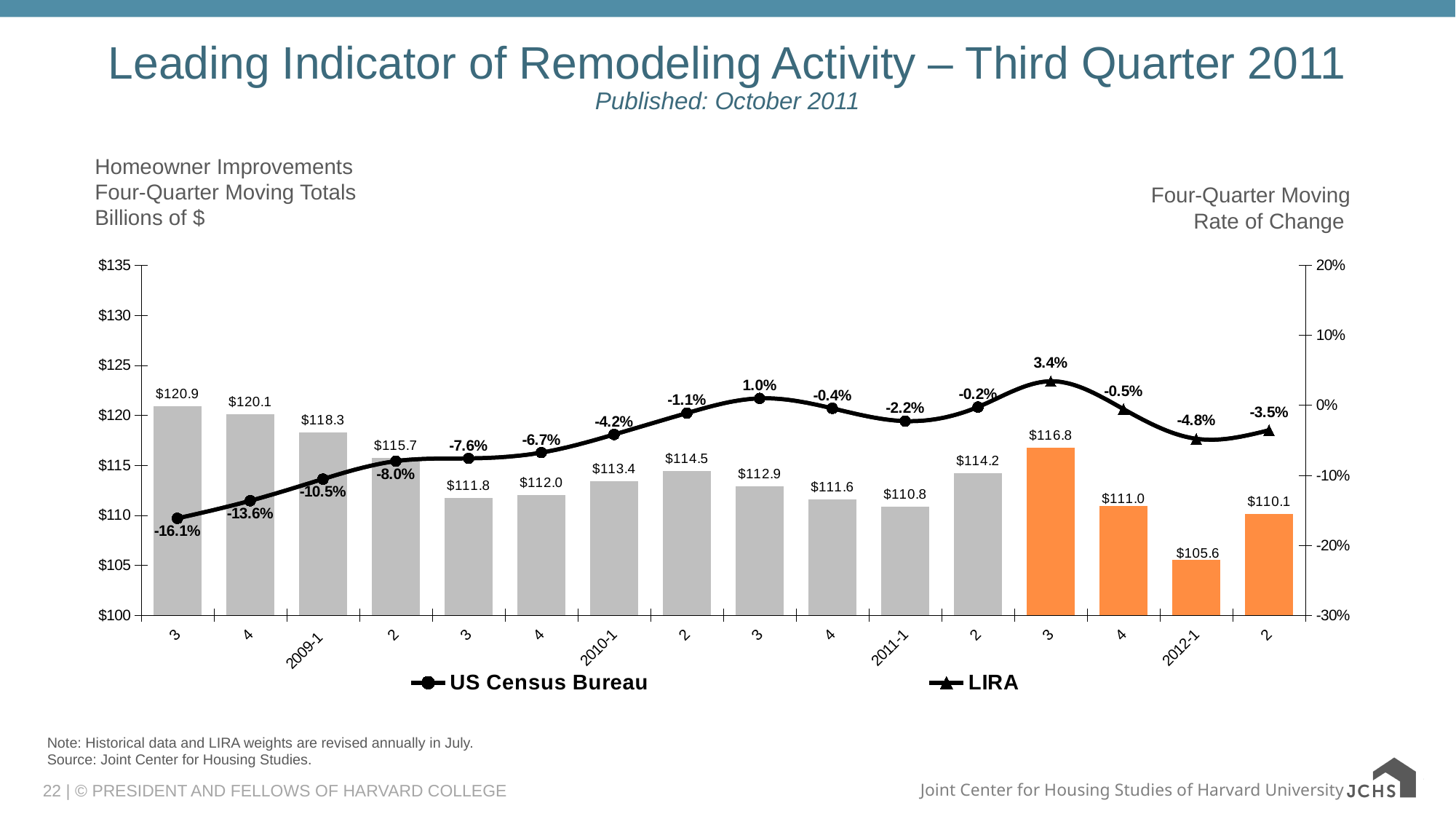
What is the four-quarter moving rate of change for 2010-1? -4.2% How many series does the legend list? 2 What is the four-quarter moving total (bar) for 2009-1? $118.3 Which has the larger four-quarter moving total bar, 2010-1 or 2011-1? 2010-1 What is the four-quarter moving total (bar) for 2011-1? $110.8 What kind of chart is this? Combined bar and line chart What is the difference between the four-quarter moving total bars for 2011-1 and 2012-1? $5.2 What is the highest four-quarter moving total shown by the bars? $120.9 What is the four-quarter moving rate of change for 2012-1? -4.8% What is the highest four-quarter moving rate of change shown on the line? 3.4% How many quarters are shown on the x axis? 16 Which quarter has the lowest four-quarter moving total bar? 2012-1